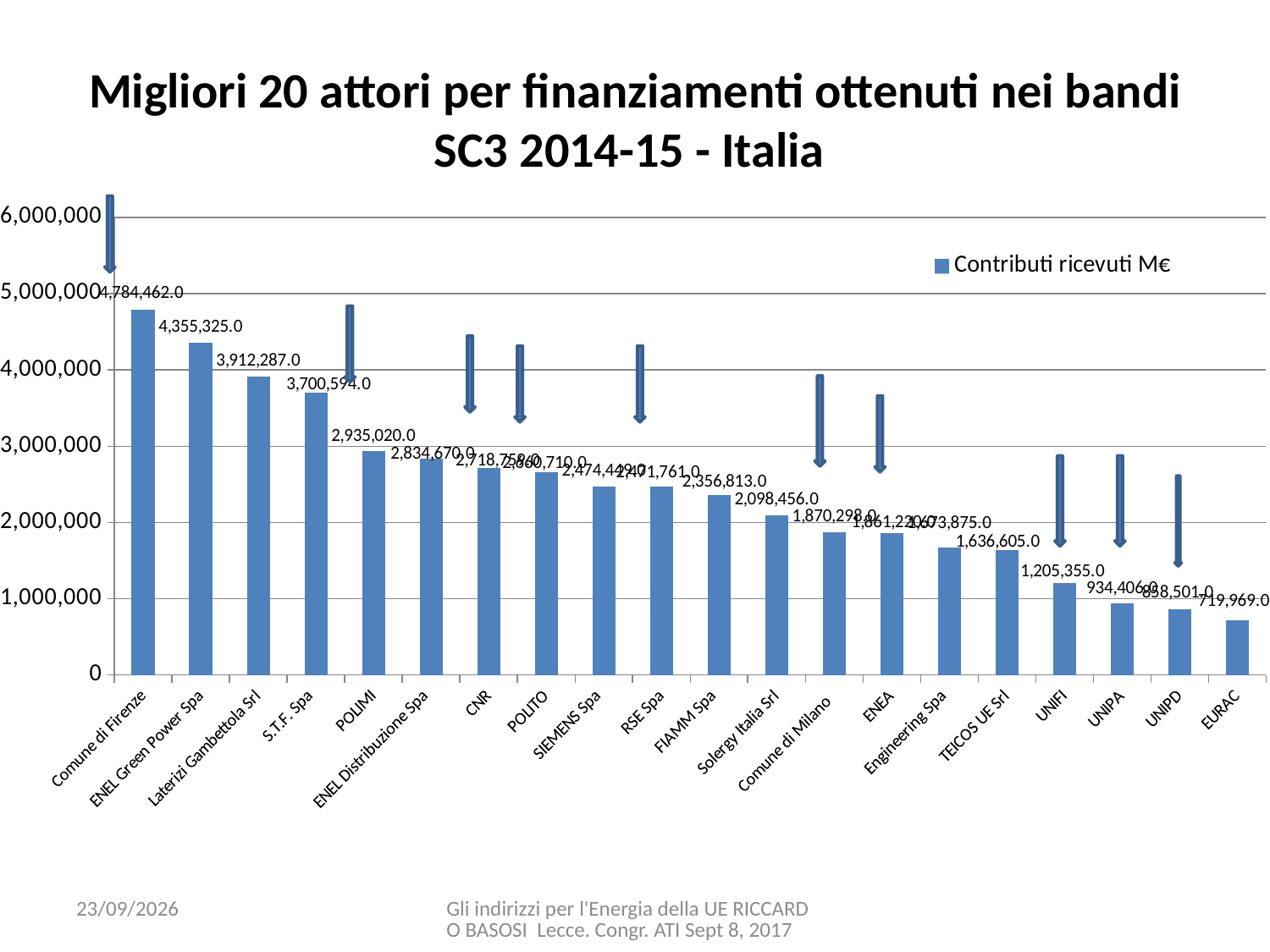
What is the value for Comune di Firenze? 4,784,462.0 Which is larger, the value for POLIMI or the value for FIAMM Spa? POLIMI What is the value for ENEL Green Power Spa? 4,355,325.0 Do the values rise or fall from left to right along the x axis? fall Is the value for CNR greater or less than 3,000,000? less What is the value for S.T.F. Spa? 3,700,594.0 How many categories are shown on the x axis? 20 What is the value for EURAC? 719,969.0 What kind of chart is shown on the slide? bar chart Which category has the highest value? Comune di Firenze Which category has the lowest value? EURAC What is the difference between the values for Comune di Firenze and ENEL Green Power Spa? 429,137.0